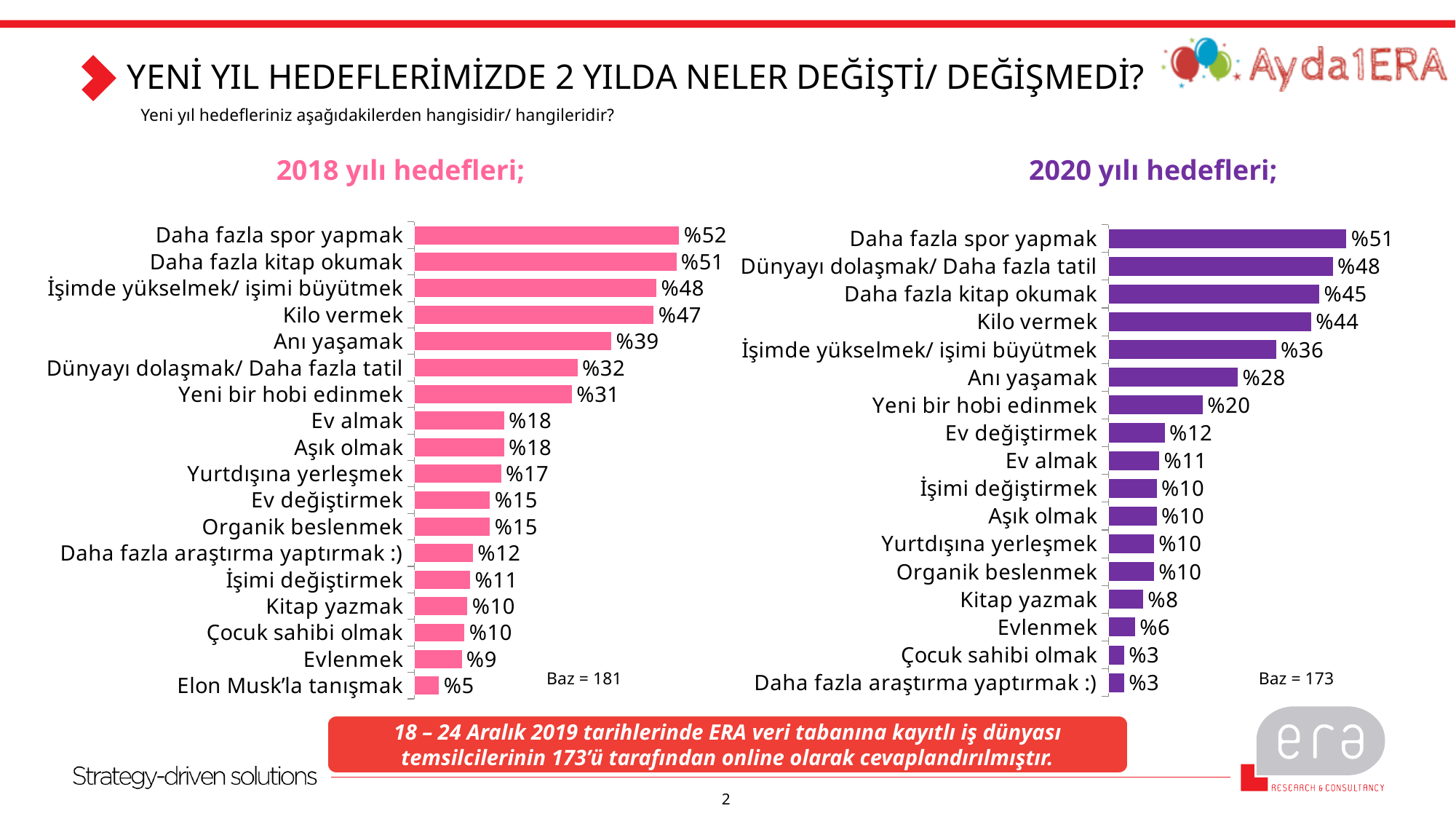
In the '2018 yılı hedefleri' chart, which category has the lowest value? Elon Musk'la tanışmak In the '2018 yılı hedefleri' chart, what is the value for 'Yeni bir hobi edinmek'? %31 In the '2018 yılı hedefleri' chart, which is larger: 'Anı yaşamak' or 'Dünyayı dolaşmak/ Daha fazla tatil'? Anı yaşamak What type of chart is the '2020 yılı hedefleri' chart? Bar chart In the '2020 yılı hedefleri' chart, what is the value for 'Dünyayı dolaşmak/ Daha fazla tatil'? %48 How many categories are shown in the '2020 yılı hedefleri' chart? 17 How many categories are shown in the '2018 yılı hedefleri' chart? 18 In the '2020 yılı hedefleri' chart, what is the difference between 'Daha fazla spor yapmak' and 'Anı yaşamak'? 23 percentage points What is the base (Baz) shown for the '2020 yılı hedefleri' chart? Baz = 173 In the '2018 yılı hedefleri' chart, what is the value for 'Kilo vermek'? %47 In the '2020 yılı hedefleri' chart, which category has the highest value? Daha fazla spor yapmak In the '2018 yılı hedefleri' chart, which category has the highest value? Daha fazla spor yapmak